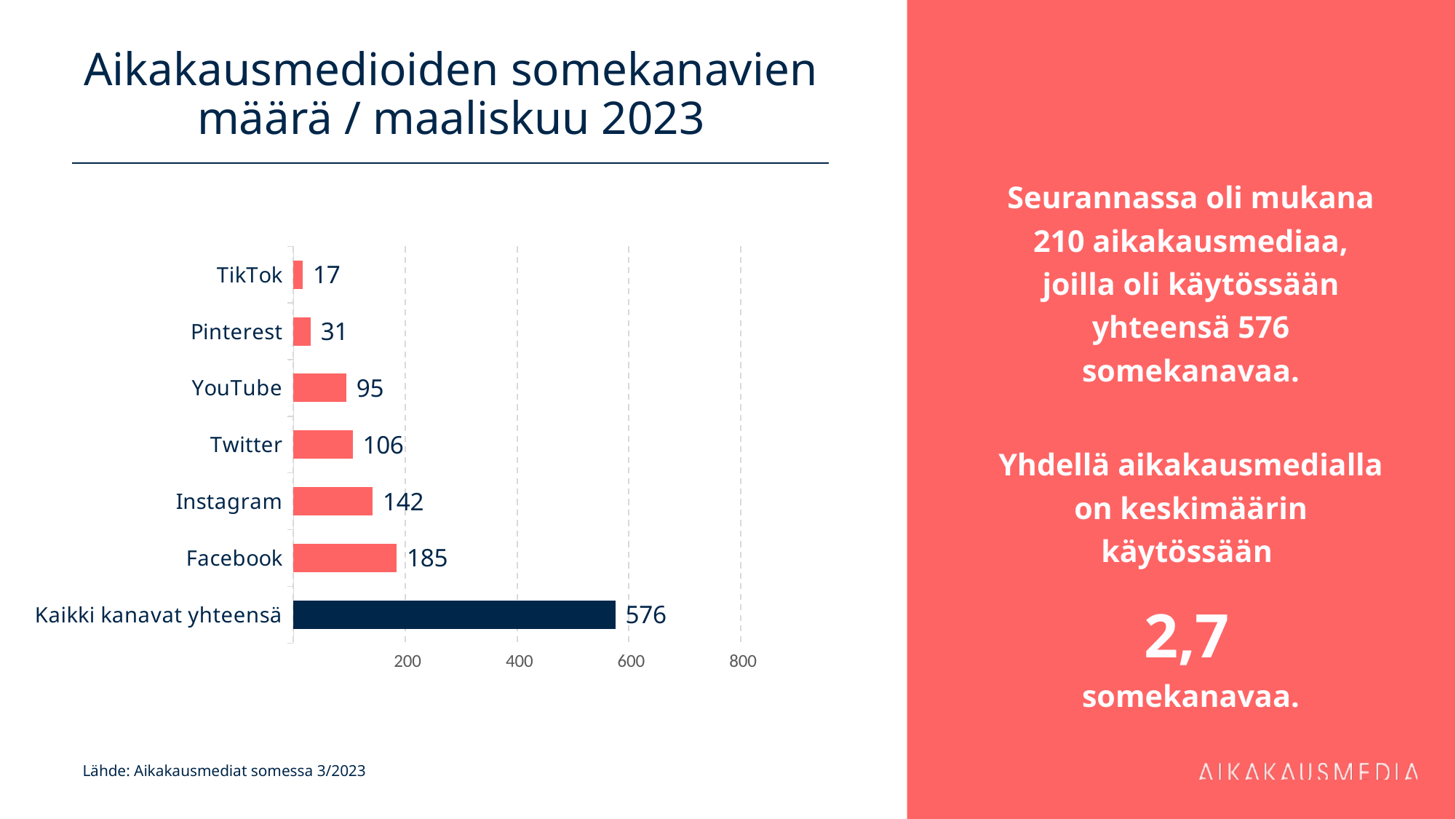
What is the difference between the values for Twitter and YouTube? 11 Which category has the lowest value? TikTok What is the value shown for Kaikki kanavat yhteensä? 576 What kind of chart is shown on the slide? Bar chart How many categories are shown on the chart? 7 What is the value for Instagram? 142 What is the value for Facebook? 185 What is the difference between the values for Facebook and Instagram? 43 What is the value for TikTok? 17 Which individual channel has the highest value? Facebook What is the title of the chart? Aikakausmedioiden somekanavien määrä / maaliskuu 2023 Which is larger, the value for Pinterest or the value for YouTube? YouTube